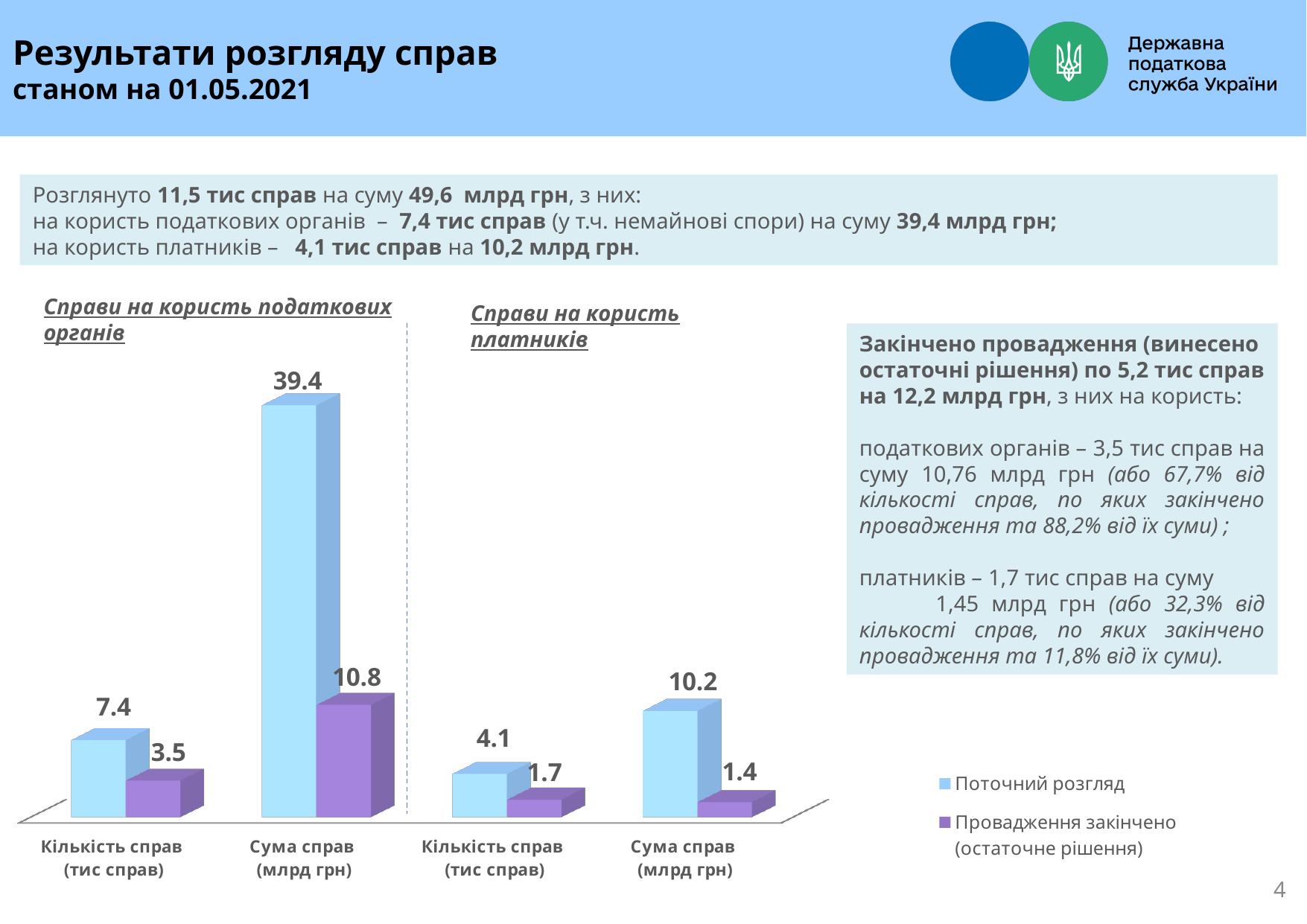
Which bar in the chart has the lowest value? Провадження закінчено (остаточне рішення), Сума справ (млрд грн) for платників (1.4) In the section 'Справи на користь платників', what is the difference between 'Поточний розгляд' and 'Провадження закінчено' for 'Кількість справ (тис справ)'? 2.4 In the section 'Справи на користь платників', what is the value of 'Поточний розгляд' for 'Сума справ (млрд грн)'? 10.2 What type of chart is shown on the slide? Bar chart Which colour represents the series 'Провадження закінчено (остаточне рішення)' in the chart? Purple Which is larger: 'Поточний розгляд' for 'Кількість справ' in the податкових органів section or 'Поточний розгляд' for 'Кількість справ' in the платників section? Податкових органів (7.4) In the section 'Справи на користь податкових органів', what is the value of 'Поточний розгляд' for 'Сума справ (млрд грн)'? 39.4 How many series does the chart legend list? 2 In the section 'Справи на користь платників', what is the value of 'Провадження закінчено (остаточне рішення)' for 'Кількість справ (тис справ)'? 1.7 Which bar in the chart has the highest value? Поточний розгляд, Сума справ (млрд грн) for податкових органів (39.4) In the section 'Справи на користь податкових органів', what is the difference between 'Поточний розгляд' and 'Провадження закінчено' for 'Сума справ (млрд грн)'? 28.6 In the section 'Справи на користь податкових органів', what is the value of 'Провадження закінчено (остаточне рішення)' for 'Кількість справ (тис справ)'? 3.5